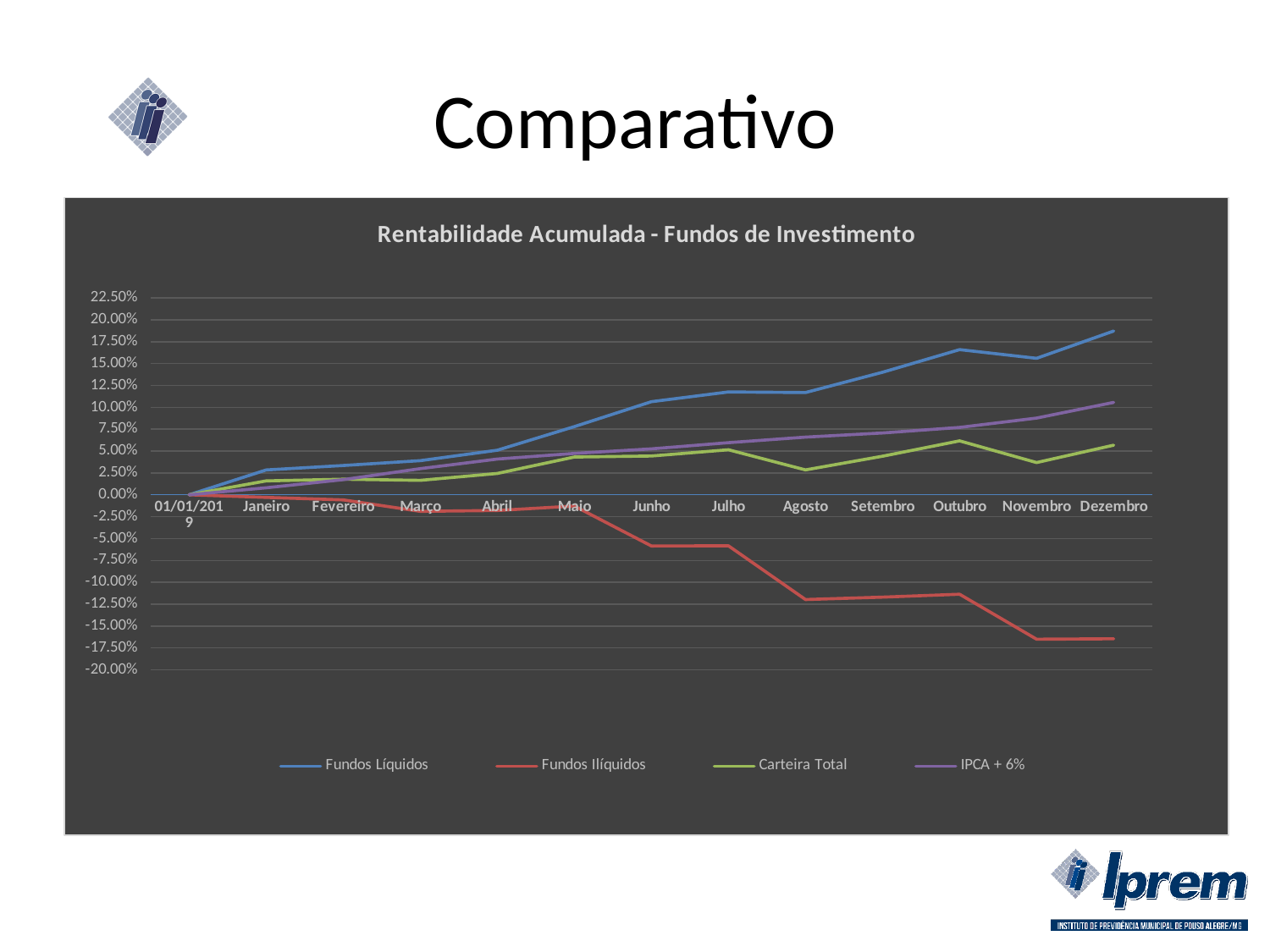
Does the Fundos Líquidos series generally rise or fall from 01/01/2019 to Dezembro? rise What kind of chart is shown on the slide? line chart Which series has the lowest value in Dezembro? Fundos Ilíquidos What is the title of the chart? Rentabilidade Acumulada - Fundos de Investimento Which series is drawn in red? Fundos Ilíquidos Is the value for Fundos Ilíquidos in Dezembro greater or less than -15.00%? less How many points are plotted along the x axis for each series? 13 Which series has the highest value in Dezembro? Fundos Líquidos Does the Fundos Ilíquidos series generally rise or fall from 01/01/2019 to Dezembro? fall In Dezembro, which is larger: Fundos Líquidos or IPCA + 6%? Fundos Líquidos How many series does the legend list? 4 Is the value for Fundos Líquidos in Dezembro greater or less than 17.50%? greater